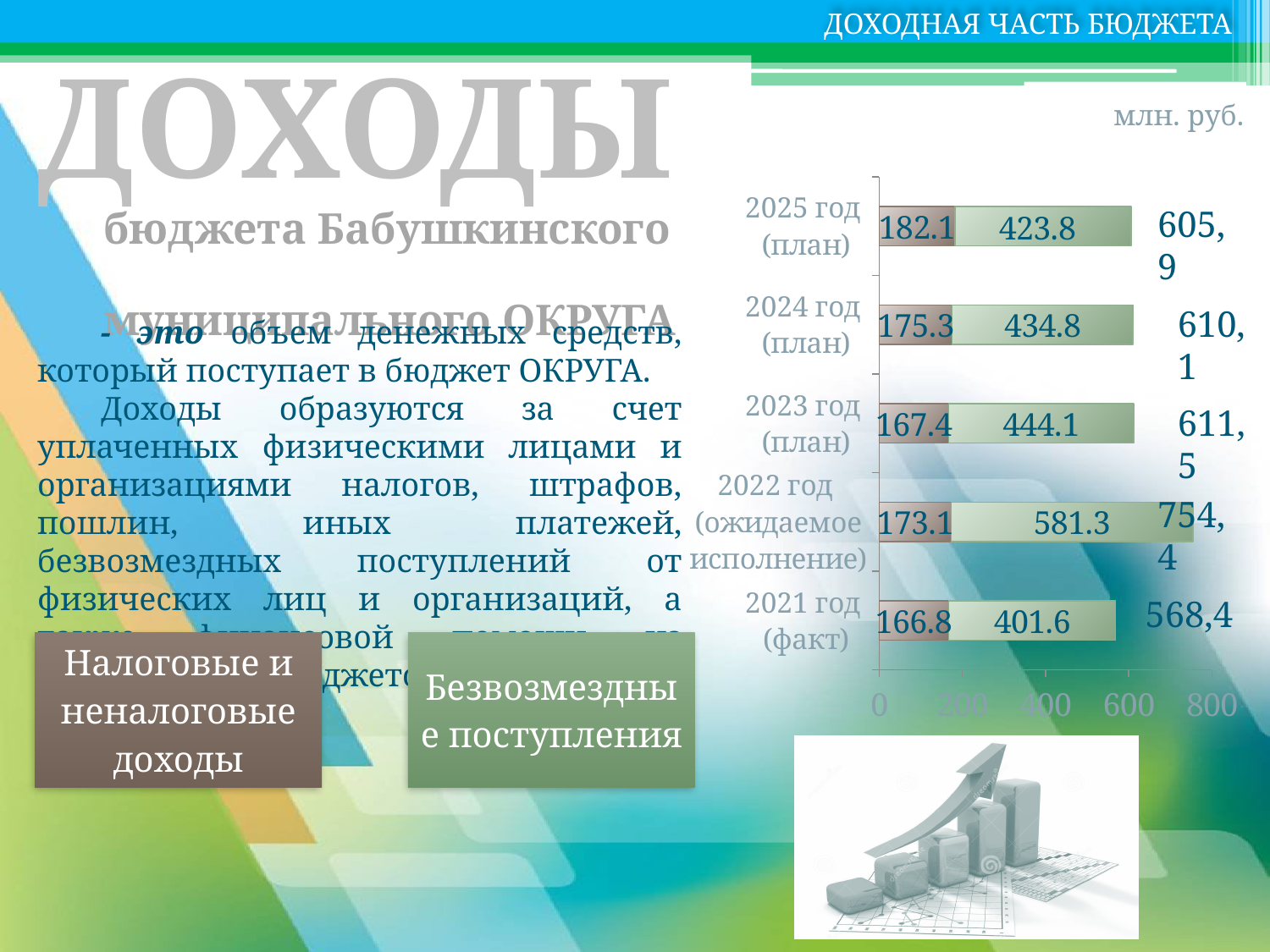
What is the difference between Безвозмездные поступления for 2023 год (план) and 2025 год (план)? 20.3 What type of chart is shown on the slide? bar chart What unit of measurement is indicated for the chart? млн. руб. Which year has the lowest value of Налоговые и неналоговые доходы? 2021 год (факт) What is the value of Налоговые и неналоговые доходы for 2025 год (план)? 182.1 How many year categories are plotted in the chart? 5 Which is larger: Безвозмездные поступления for 2024 год (план) or for 2021 год (факт)? 2024 год (план) Is the total for 2022 год (ожидаемое исполнение) greater or less than 600? greater How many data series does the chart's legend list? 2 What is the total shown for the 2021 год (факт) bar? 568,4 Which year has the highest total revenue? 2022 год (ожидаемое исполнение) What is the value of Безвозмездные поступления for 2022 год (ожидаемое исполнение)? 581.3